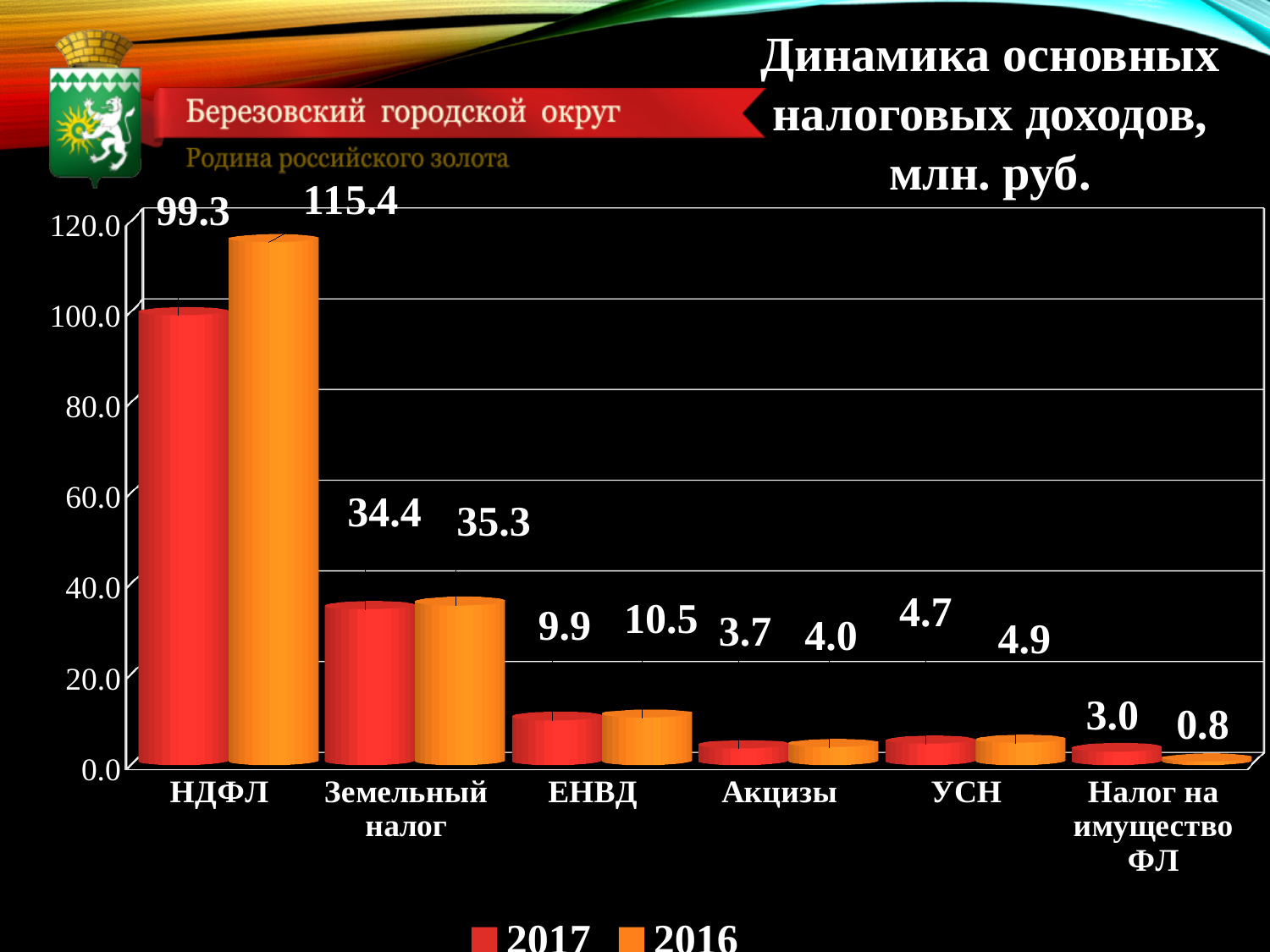
How many categories are shown on the x axis? 6 What is the value for НДФЛ in 2017? 99.3 How many series does the legend list? 2 What is the title of the chart? Динамика основных налоговых доходов, млн. руб. What is the value for Налог на имущество ФЛ in 2017? 3.0 What kind of chart is shown on the slide? bar chart What is the value for НДФЛ in 2016? 115.4 Which category has the highest value in 2016? НДФЛ What is the value for Земельный налог in 2016? 35.3 Which category has the lowest value in 2016? Налог на имущество ФЛ Which is larger for ЕНВД: the 2017 value or the 2016 value? 2016 What is the difference between the 2016 and 2017 values for НДФЛ? 16.1